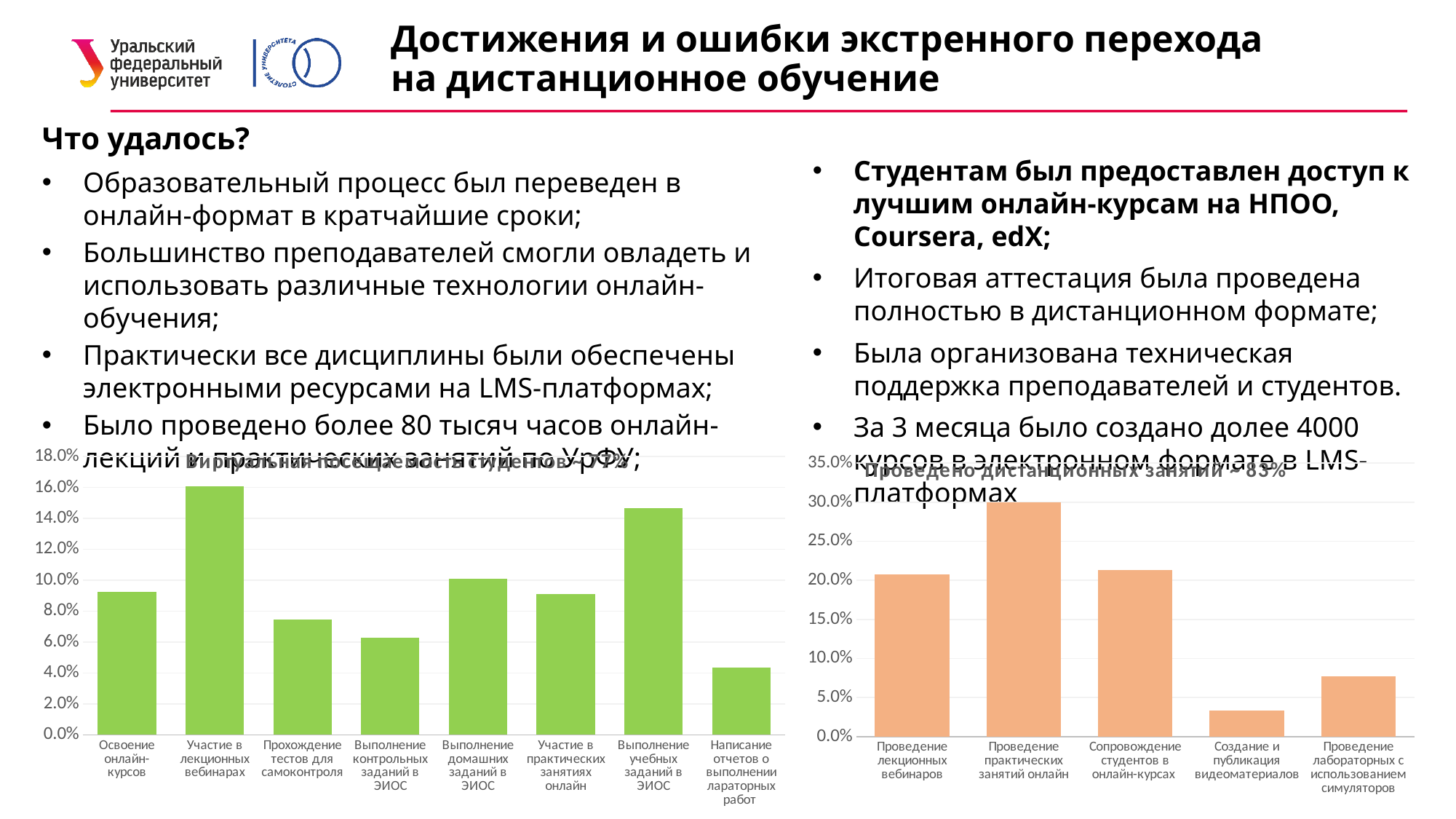
What kind of chart is the left chart on the slide? bar chart In the right chart, is the value for Проведение лабораторных с использованием симуляторов greater or less than 10.0%? less In the left chart, is the value for Выполнение контрольных заданий в ЭИОС greater or less than 8.0%? less In the right chart, which category has the lowest value? Создание и публикация видеоматериалов In the left chart, is the value for Участие в лекционных вебинарах greater or less than 14.0%? greater How many categories does the right chart show? 5 In the left chart, which is larger: Выполнение учебных заданий в ЭИОС or Прохождение тестов для самоконтроля? Выполнение учебных заданий в ЭИОС In the left chart, which category has the lowest value? Написание отчетов о выполнении лараторных работ In the left chart, which category has the highest value? Участие в лекционных вебинарах In the right chart, which category has the highest value? Проведение практических занятий онлайн How many categories does the left chart show? 8 In the right chart, which is larger: Проведение практических занятий онлайн or Сопровождение студентов в онлайн-курсах? Проведение практических занятий онлайн